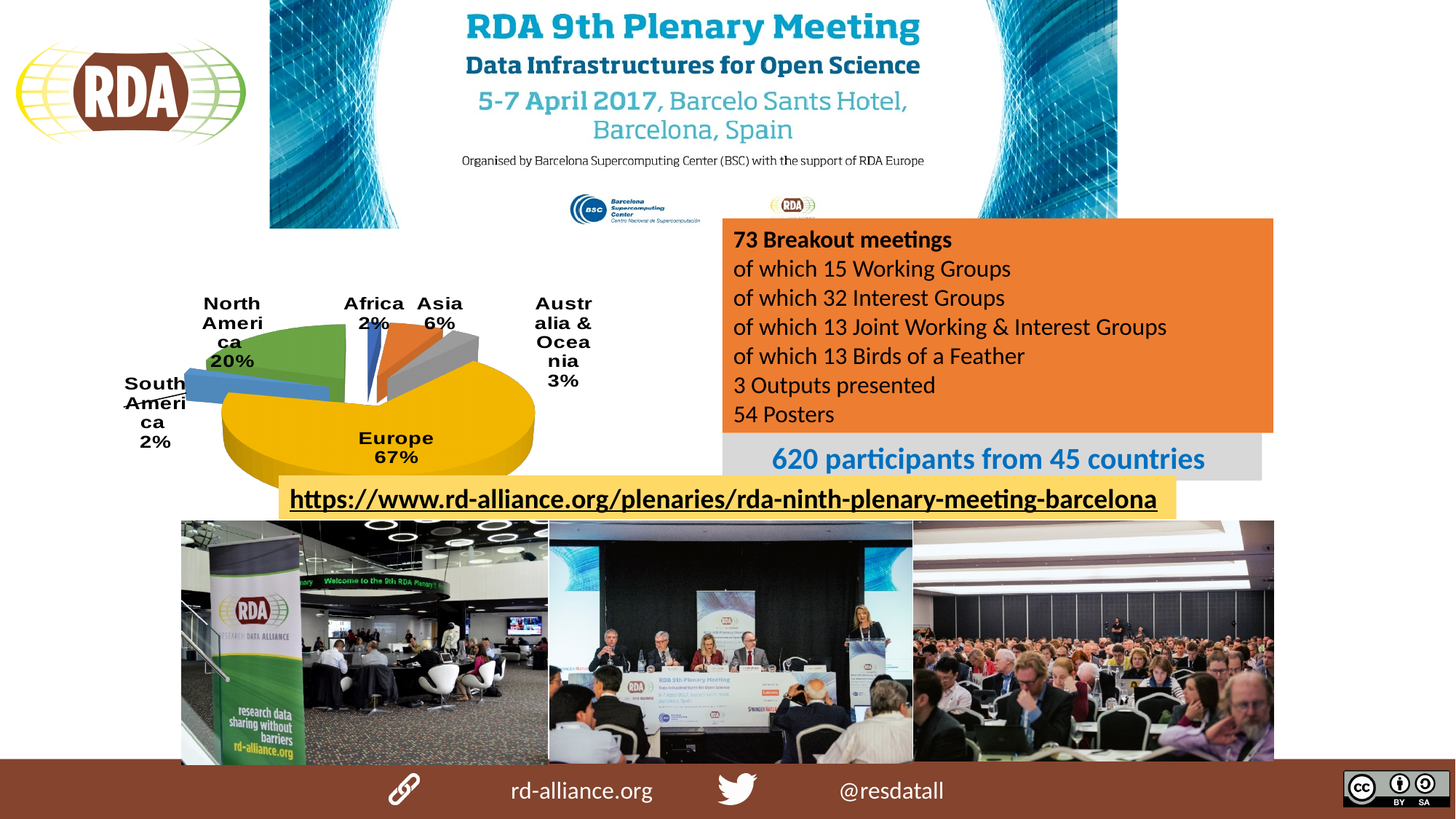
What share of the pie does North America have? 20% What share of the pie does Europe have? 67% Which region has the largest slice of the pie? Europe Which is larger, the share for North America or the share for Asia? North America What share of the pie does Africa have? 2% What kind of chart is shown on the slide? Pie chart What is the difference in percentage points between Asia's share and Australia & Oceania's share? 3 What share of the pie does Asia have? 6% What share of the pie does Australia & Oceania have? 3% What colour is the Europe slice of the pie chart? Yellow How many slices does the pie chart have? 6 What is the difference in percentage points between Europe's share and North America's share? 47